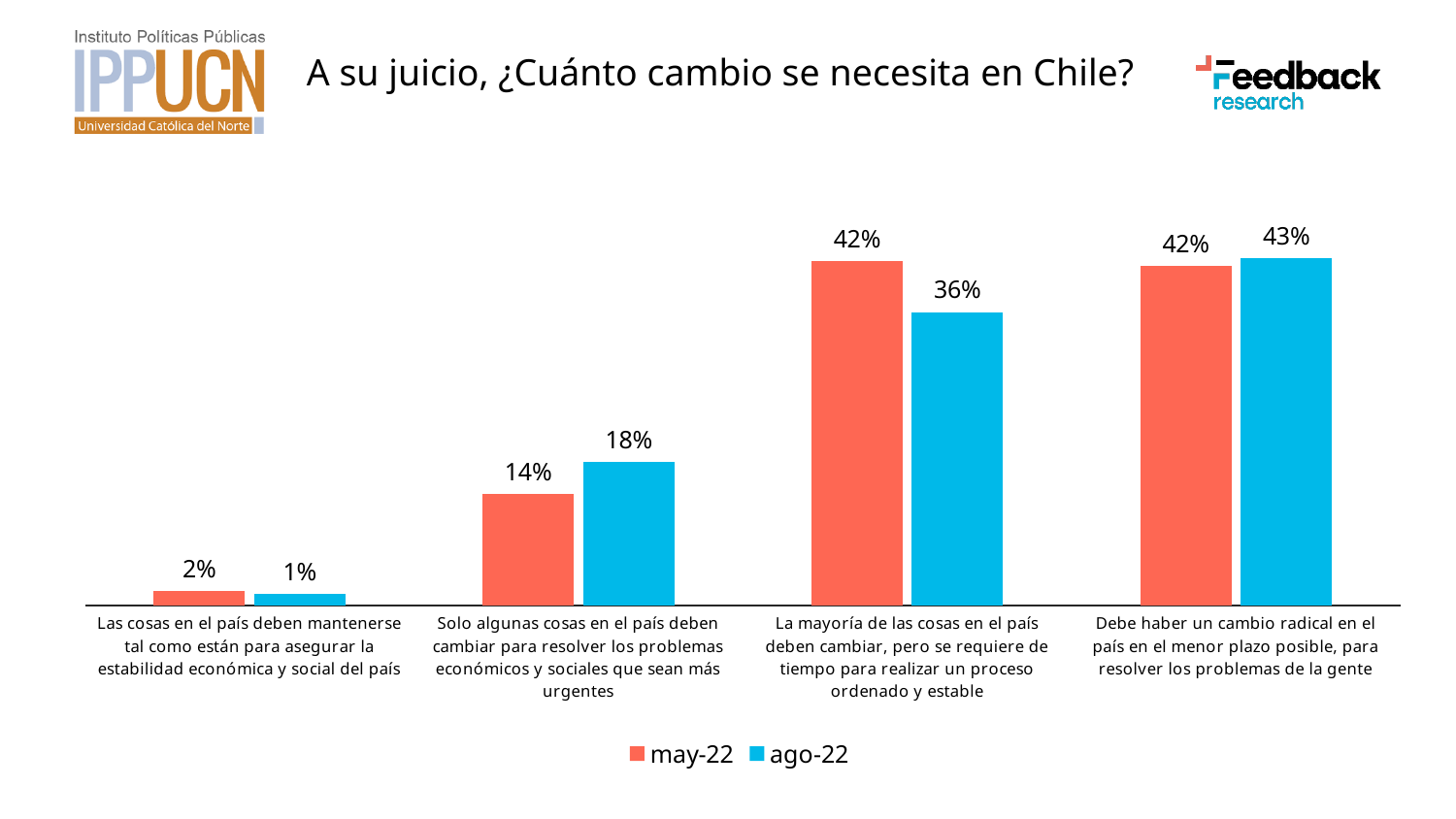
What is the difference between the may-22 and ago-22 values for 'La mayoría de las cosas en el país deben cambiar, pero se requiere de tiempo para realizar un proceso ordenado y estable'? 6% Which category has the lowest ago-22 value? Las cosas en el país deben mantenerse tal como están para asegurar la estabilidad económica y social del país What is the may-22 value for 'Debe haber un cambio radical en el país en el menor plazo posible, para resolver los problemas de la gente'? 42% What kind of chart is shown on the slide? Bar chart For 'Solo algunas cosas en el país deben cambiar para resolver los problemas económicos y sociales que sean más urgentes', which series has the larger value, may-22 or ago-22? ago-22 How many categories are shown on the x axis? 4 How many series does the legend list? 2 Which series is shown in blue in the legend? ago-22 What is the ago-22 value for 'Solo algunas cosas en el país deben cambiar para resolver los problemas económicos y sociales que sean más urgentes'? 18% What is the title of the chart? A su juicio, ¿Cuánto cambio se necesita en Chile? Which category has the highest ago-22 value? Debe haber un cambio radical en el país en el menor plazo posible, para resolver los problemas de la gente What is the ago-22 value for 'La mayoría de las cosas en el país deben cambiar, pero se requiere de tiempo para realizar un proceso ordenado y estable'? 36%